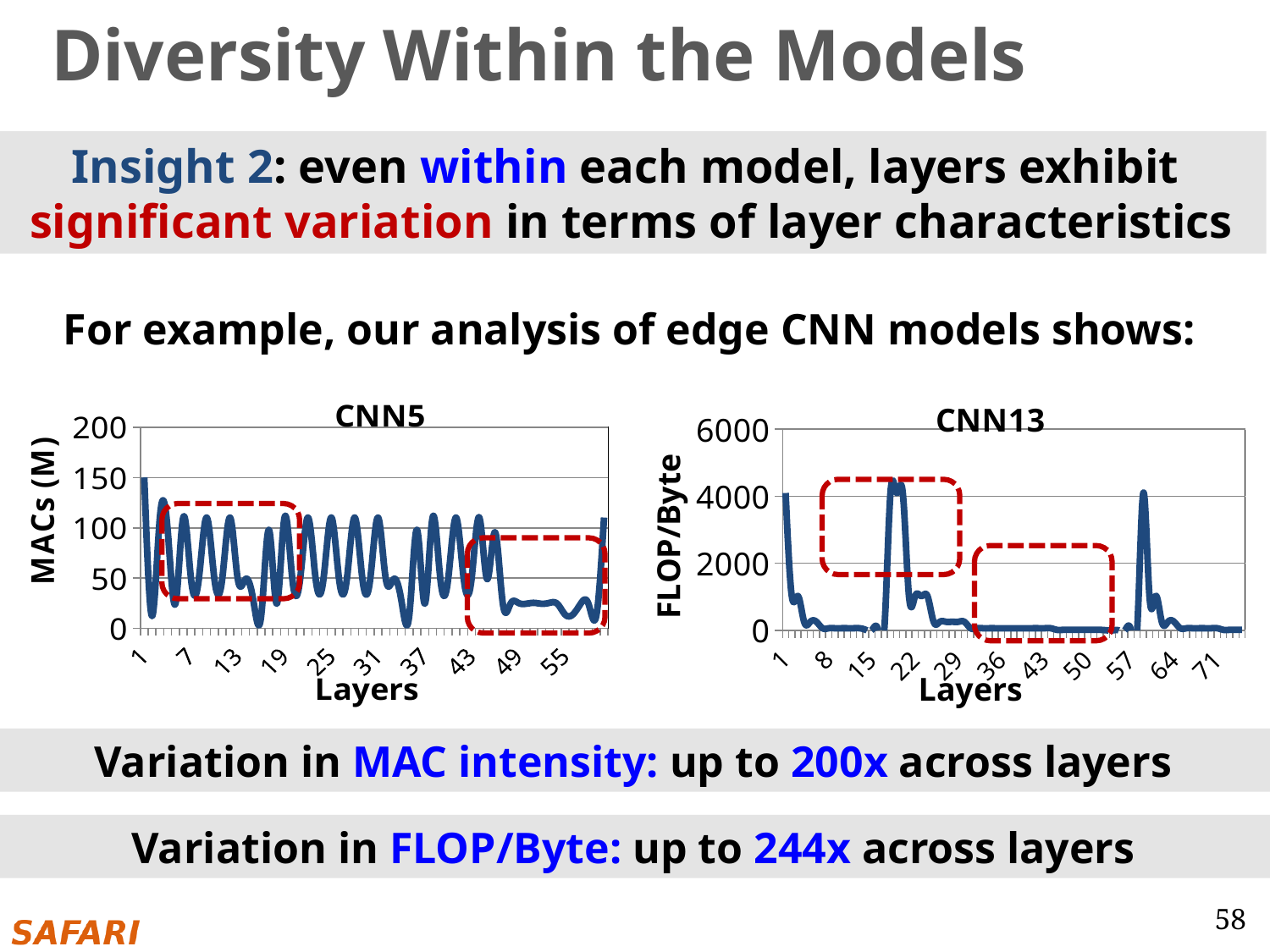
In the CNN5 chart, is the value at layer 1 greater or less than 100? greater What kind of chart is the CNN5 chart? line chart In the CNN13 chart, is the value at layer 1 greater or less than 2000? greater In the CNN5 chart, is the value at layer 49 greater or less than 50? less In the CNN13 chart, is the value at layer 1 larger or smaller than the value at layer 8? larger What kind of chart is the CNN13 chart? line chart In the CNN5 chart, is the value at layer 1 larger or smaller than the value at layer 49? larger What is the y-axis label of the CNN5 chart? MACs (M) What is the y-axis label of the CNN13 chart? FLOP/Byte